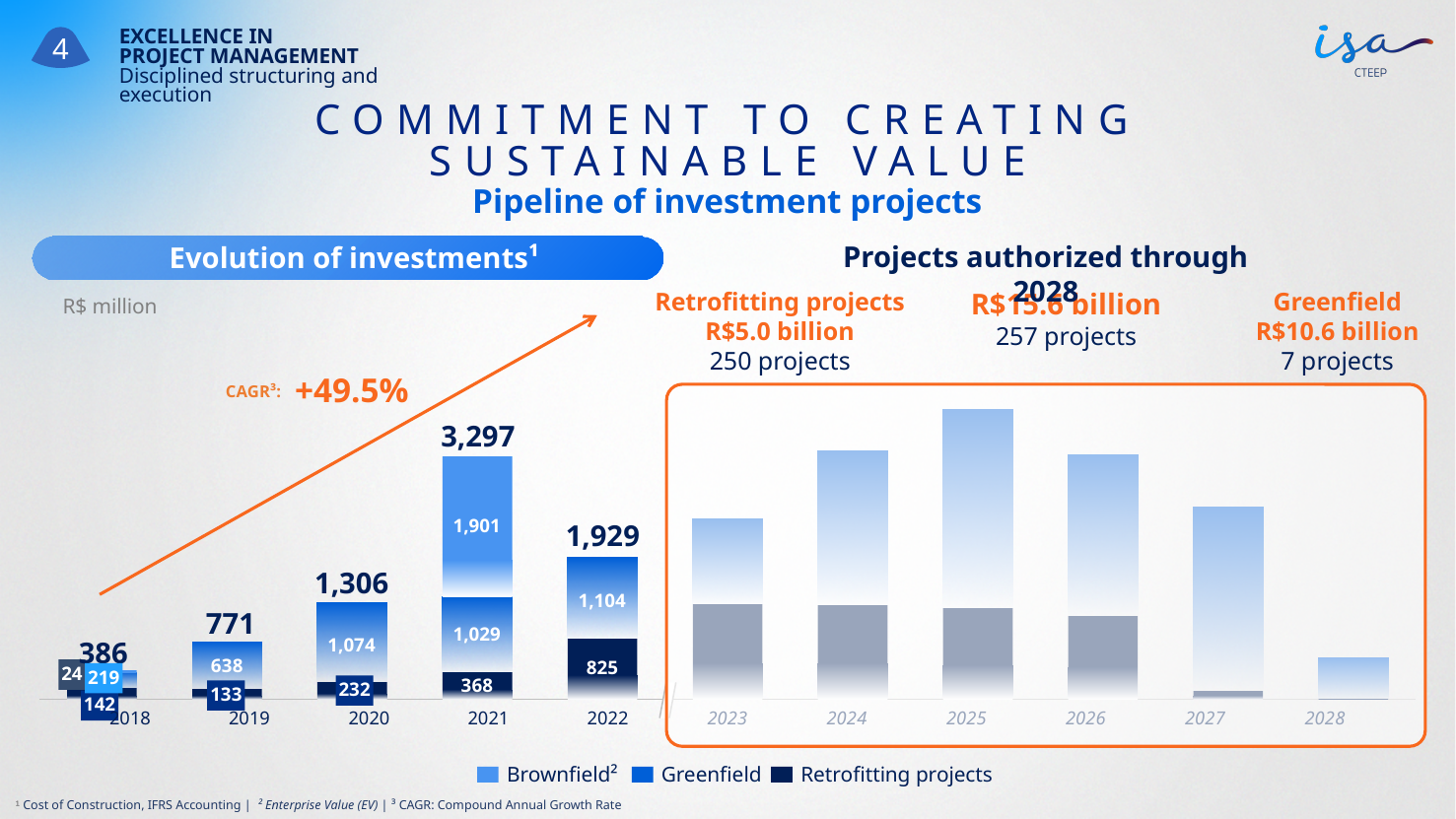
How many series does the legend list? 3 Which year has the highest total investment among the labeled years 2018–2022? 2021 What is the Retrofitting projects value for 2022? 825 What type of chart is shown under 'Evolution of investments'? bar chart What is the total investment value shown for 2021? 3,297 Do the total investments rise or fall from 2018 to 2021? rise What CAGR is shown on the chart? +49.5% What is the total investment value shown for 2022? 1,929 Which year has the lowest total investment among the labeled years 2018–2022? 2018 What is the difference between the total investment in 2021 and in 2022? 1,368 Which year has a larger total investment, 2019 or 2020? 2020 What is the Greenfield value for 2019? 638